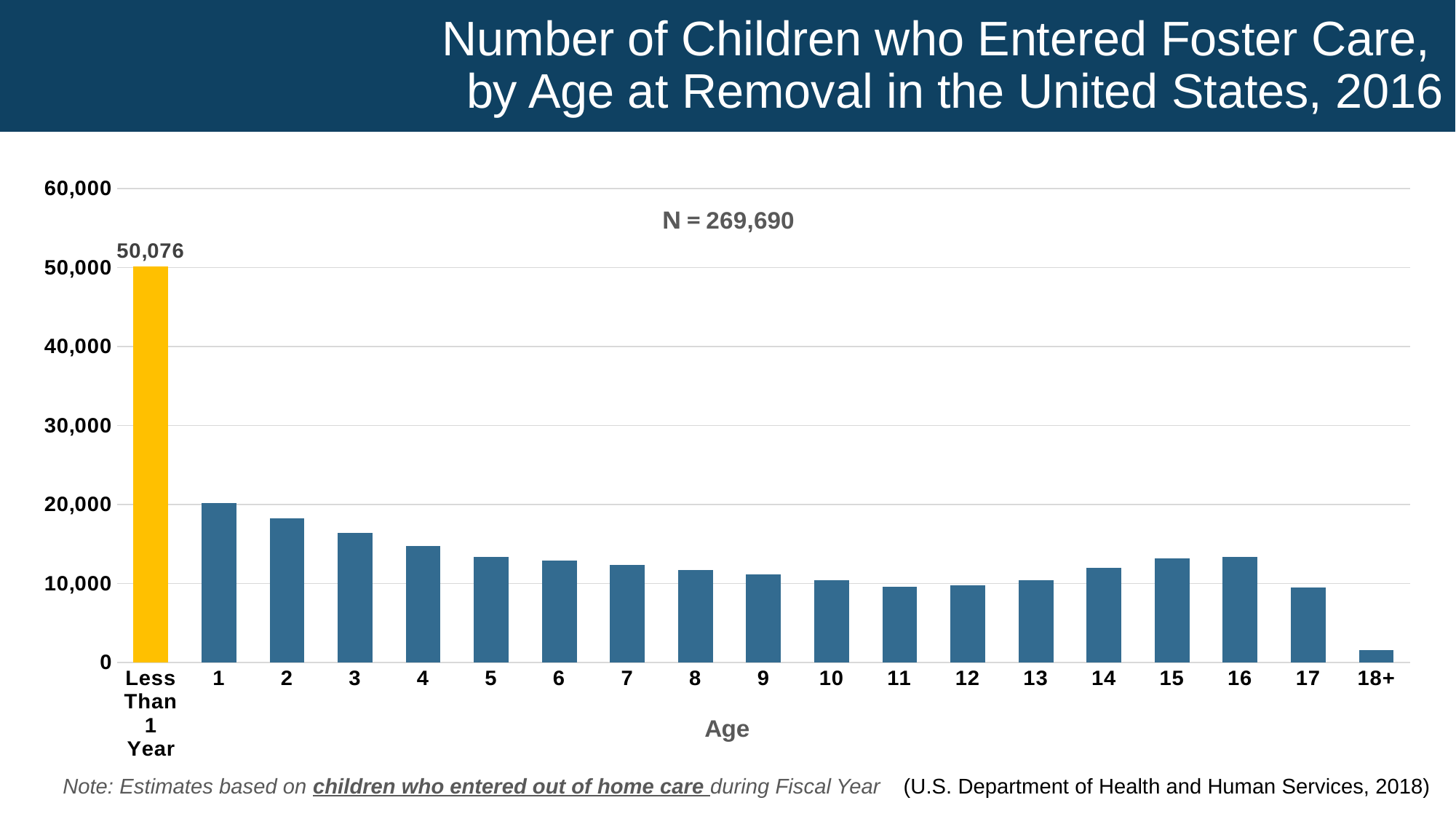
What kind of chart is shown on the slide? bar chart What is the number of children who entered foster care at less than 1 year of age? 50,076 Which age category has the highest number of children entering foster care? Less Than 1 Year What is the total N shown on the chart? N = 269,690 Which is larger, the value for age 2 or the value for age 17? age 2 Do the values rise or fall from age 1 to age 11? fall Is the value for age 3 greater or less than 20,000? less Which age category has the lowest number of children entering foster care? 18+ Which is larger, the value for age 15 or the value for age 18+? age 15 How many age categories are shown on the x axis? 19